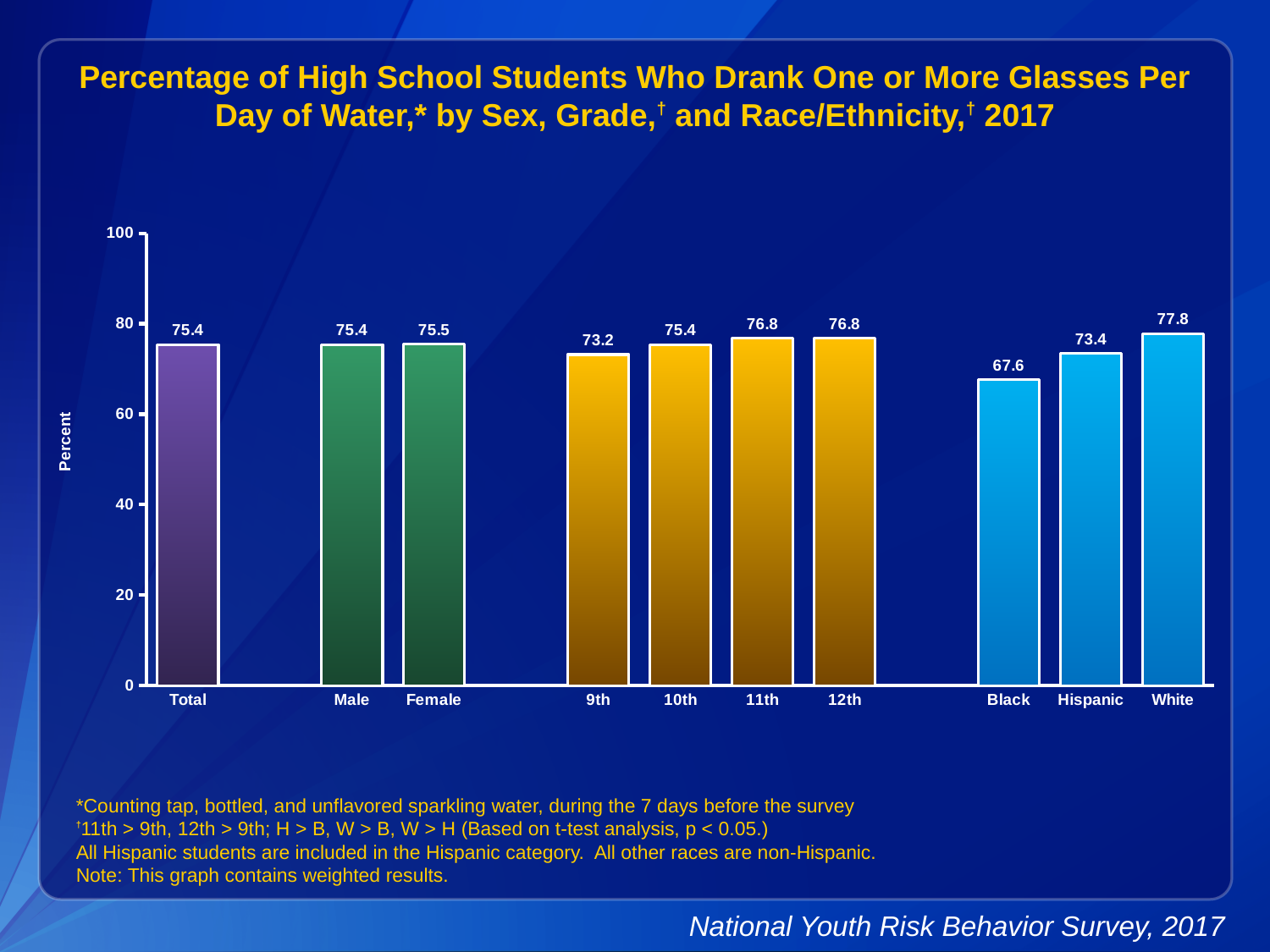
Which category has the lowest value? Black What is the value for Black students? 67.6 Which is larger, the value for 10th grade or the value for 12th grade? 12th How many bars are shown in the chart? 10 What kind of chart is shown on the slide? Bar chart What is the difference between the values for 11th grade and 9th grade? 3.6 What is the difference between the values for White and Black students? 10.2 What is the value for 9th grade? 73.2 What is the value for Total? 75.4 Is the value for Black students greater or less than 60? greater Which category has the highest value? White What is the value for Hispanic students? 73.4